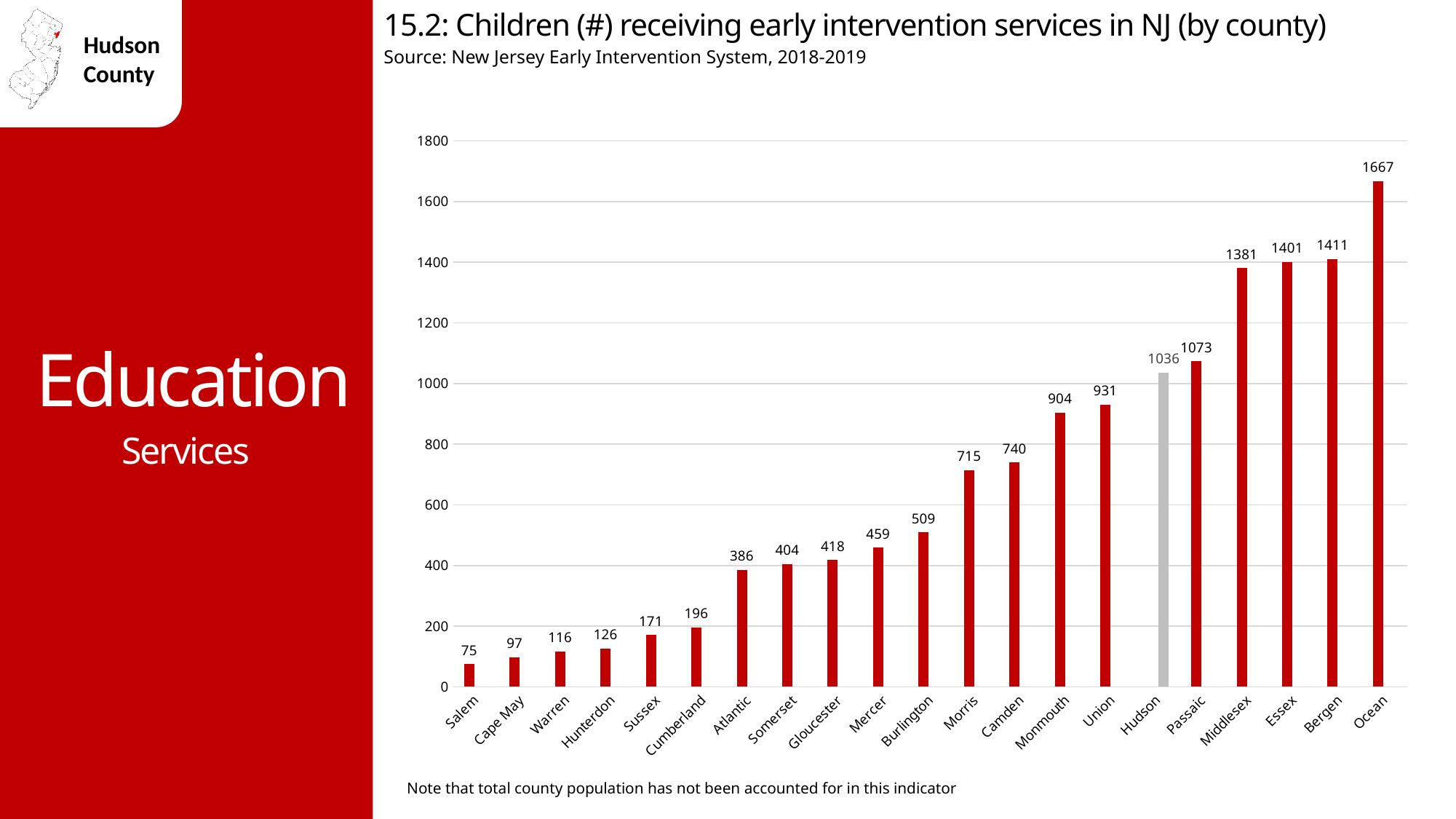
Is the value for Union greater or less than 1000? less What is the difference between the values for Bergen and Essex? 10 Which county has the lowest number of children receiving early intervention services? Salem Which has a larger value, Camden or Morris? Camden How many counties are shown on the x axis? 21 What is the value shown for Mercer County? 459 Which county's bar is coloured grey instead of red? Hudson What is the value shown for Ocean County? 1667 What is the difference between the values for Ocean and Hudson? 631 Which county has the highest number of children receiving early intervention services? Ocean How many children received early intervention services in Hudson County? 1036 What kind of chart is shown on the slide? Bar chart